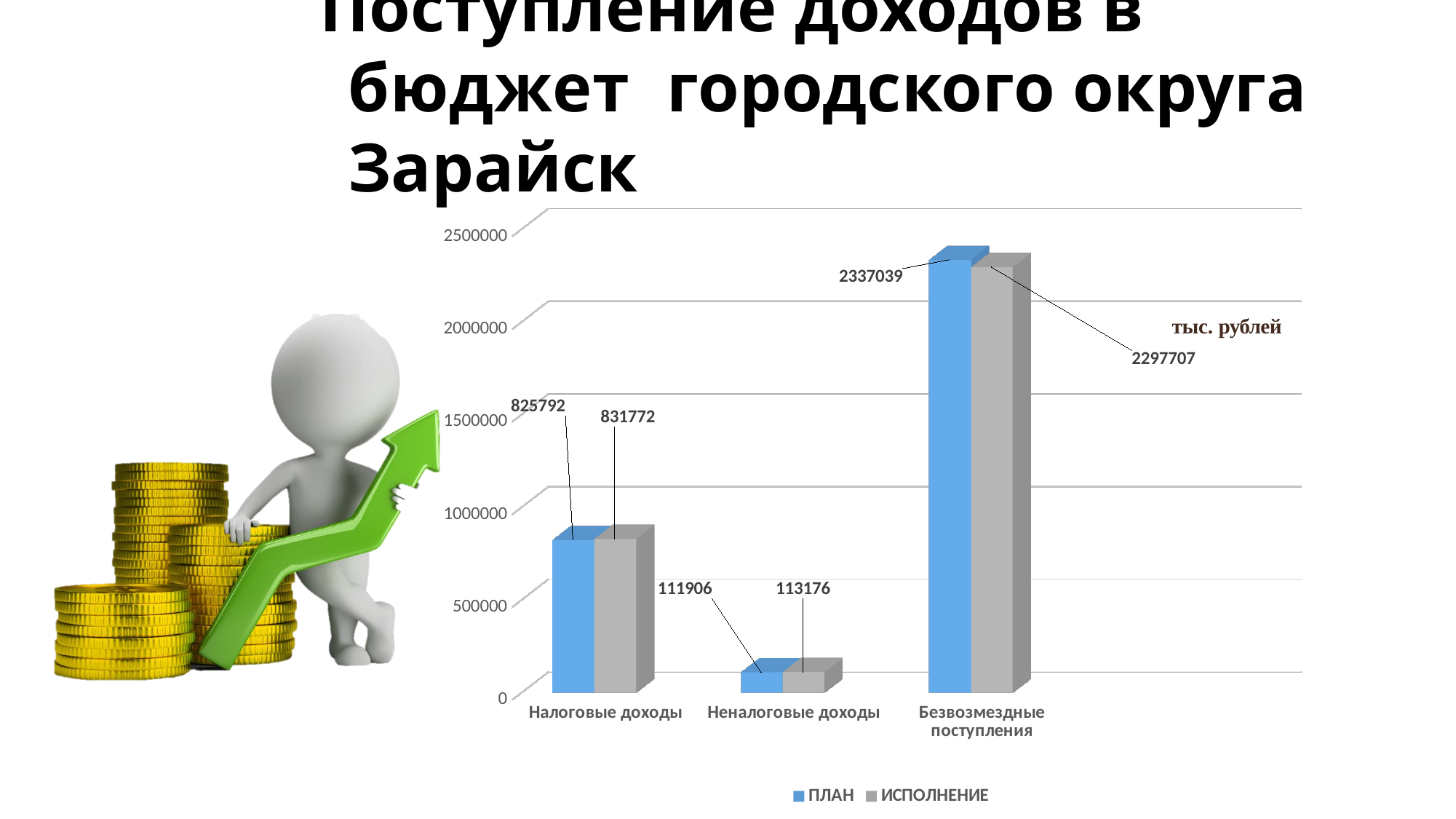
What kind of chart is shown on the slide? bar chart What is the ИСПОЛНЕНИЕ value for Безвозмездные поступления? 2297707 How many categories are shown on the x axis? 3 What is the ПЛАН value for Налоговые доходы? 825792 What is the ПЛАН value for Неналоговые доходы? 111906 How many series does the legend list? 2 Is the ИСПОЛНЕНИЕ value for Налоговые доходы greater or less than 1000000? less Which category has the lowest ИСПОЛНЕНИЕ value? Неналоговые доходы What is the ИСПОЛНЕНИЕ value for Налоговые доходы? 831772 For Неналоговые доходы, which is larger: ПЛАН or ИСПОЛНЕНИЕ? ИСПОЛНЕНИЕ What is the difference between the ПЛАН and ИСПОЛНЕНИЕ values for Безвозмездные поступления? 39332 Which category has the highest ПЛАН value? Безвозмездные поступления